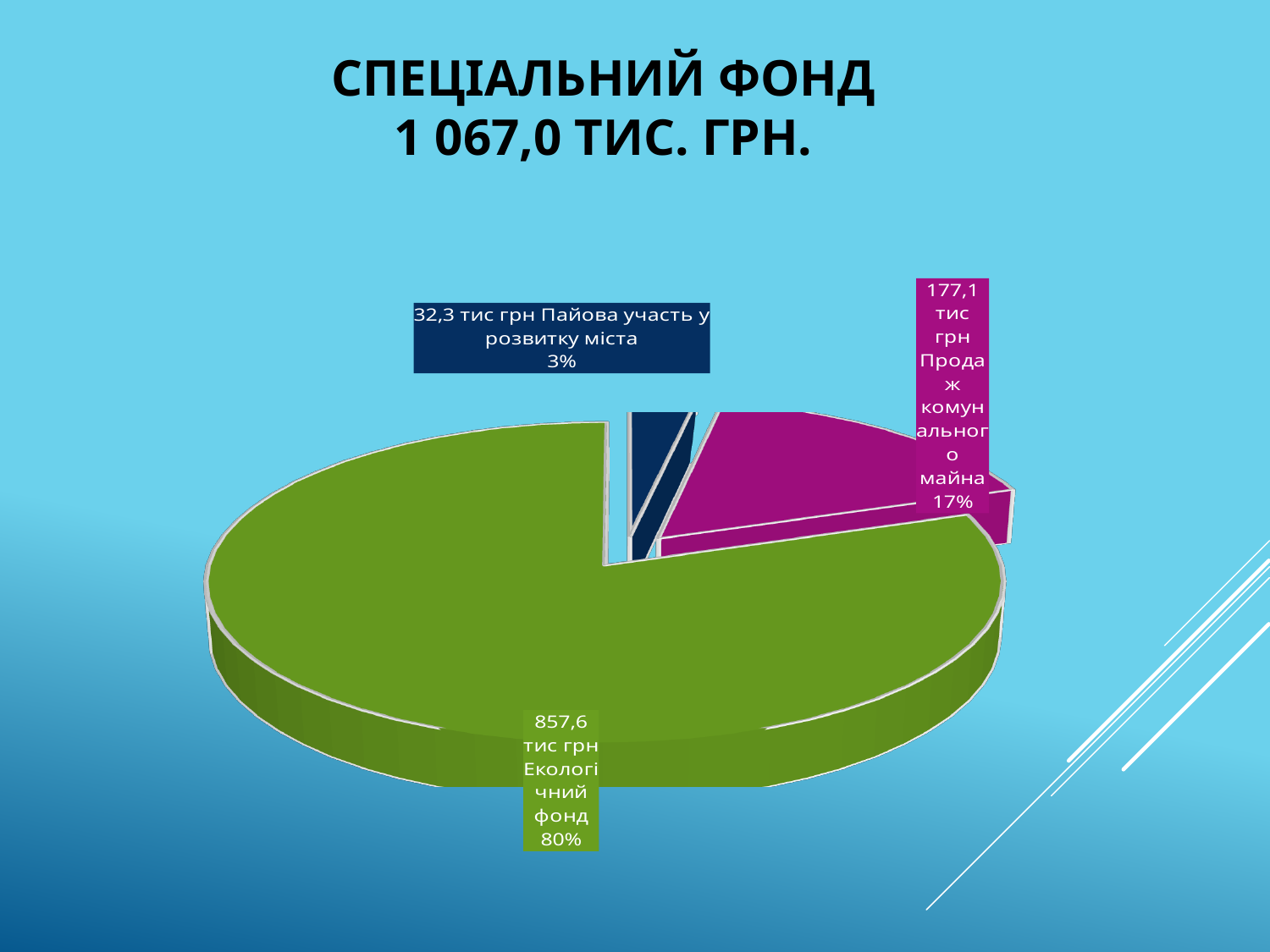
What is the value for Продаж комунального майна? 177,1 тис грн Which is larger, the value for Продаж комунального майна or the value for Пайова участь у розвитку міста? Продаж комунального майна What is the value for Пайова участь у розвитку міста? 32,3 тис грн What share of the pie does Екологічний фонд represent? 80% What kind of chart is shown on the slide? Pie chart What total amount is stated in the slide title for the Спеціальний фонд? 1 067,0 тис. грн. How many slices does the pie chart have? 3 What share of the pie does Продаж комунального майна represent? 17% Which category has the largest slice of the pie? Екологічний фонд What is the difference between the values for Екологічний фонд and Продаж комунального майна? 680,5 тис грн What is the value for Екологічний фонд? 857,6 тис грн Which category has the smallest slice of the pie? Пайова участь у розвитку міста